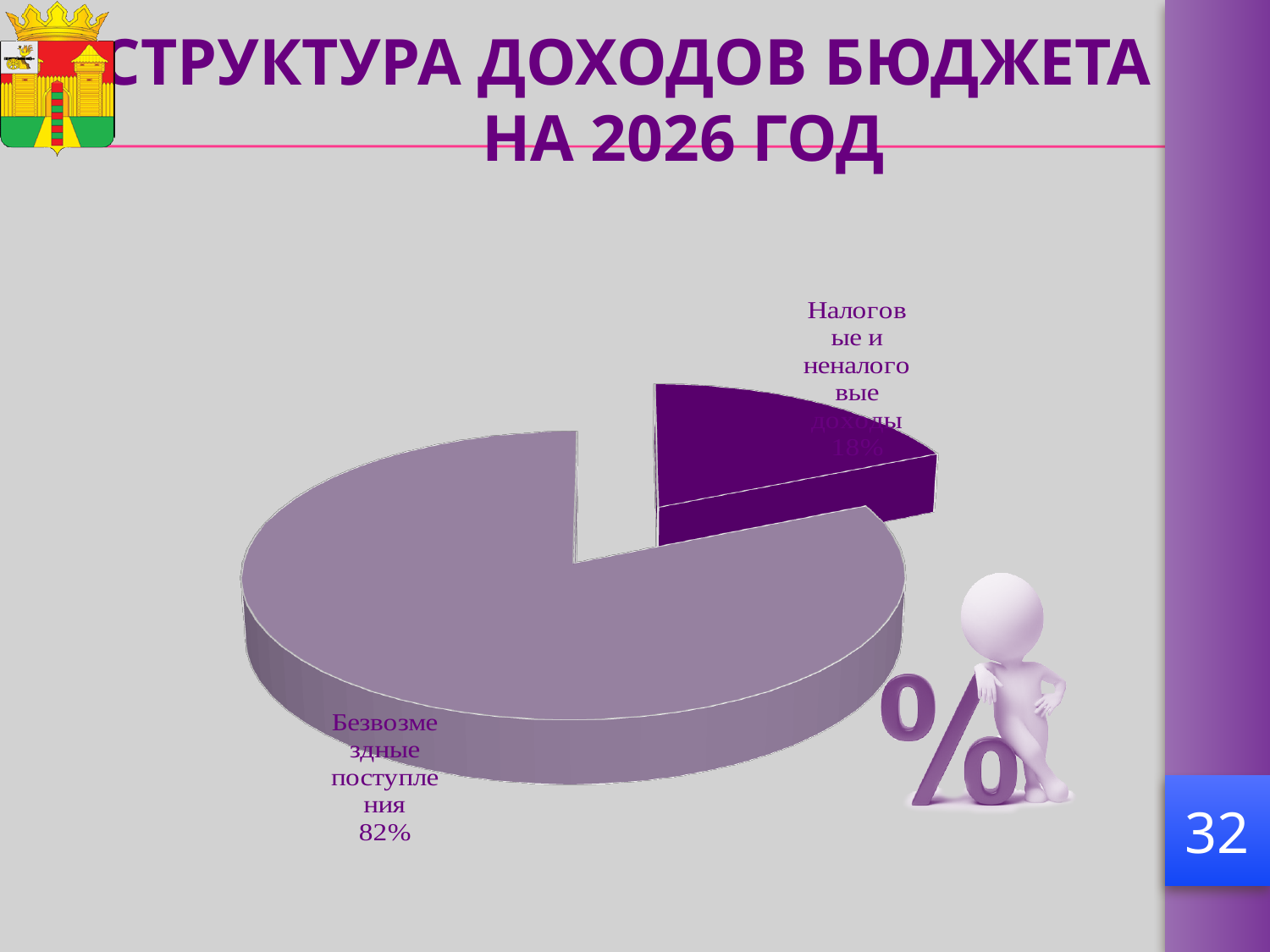
What share of the pie is labelled "Безвозмездные поступления"? 82% Which year does the chart title refer to? 2026 How many slices does the pie chart have? 2 Is the share for "Безвозмездные поступления" greater or less than 50%? greater Which slice of the pie chart is the largest? Безвозмездные поступления What kind of chart is shown on the slide? pie chart Is the share for "Налоговые и неналоговые доходы" greater or less than 25%? less What is the title of the chart on the slide? СТРУКТУРА ДОХОДОВ БЮДЖЕТА НА 2026 ГОД Which is larger: the share for "Безвозмездные поступления" or the share for "Налоговые и неналоговые доходы"? Безвозмездные поступления What is the difference in percentage points between the "Безвозмездные поступления" share and the "Налоговые и неналоговые доходы" share? 64 Which slice of the pie chart is the smallest? Налоговые и неналоговые доходы What share of the pie is labelled "Налоговые и неналоговые доходы"? 18%